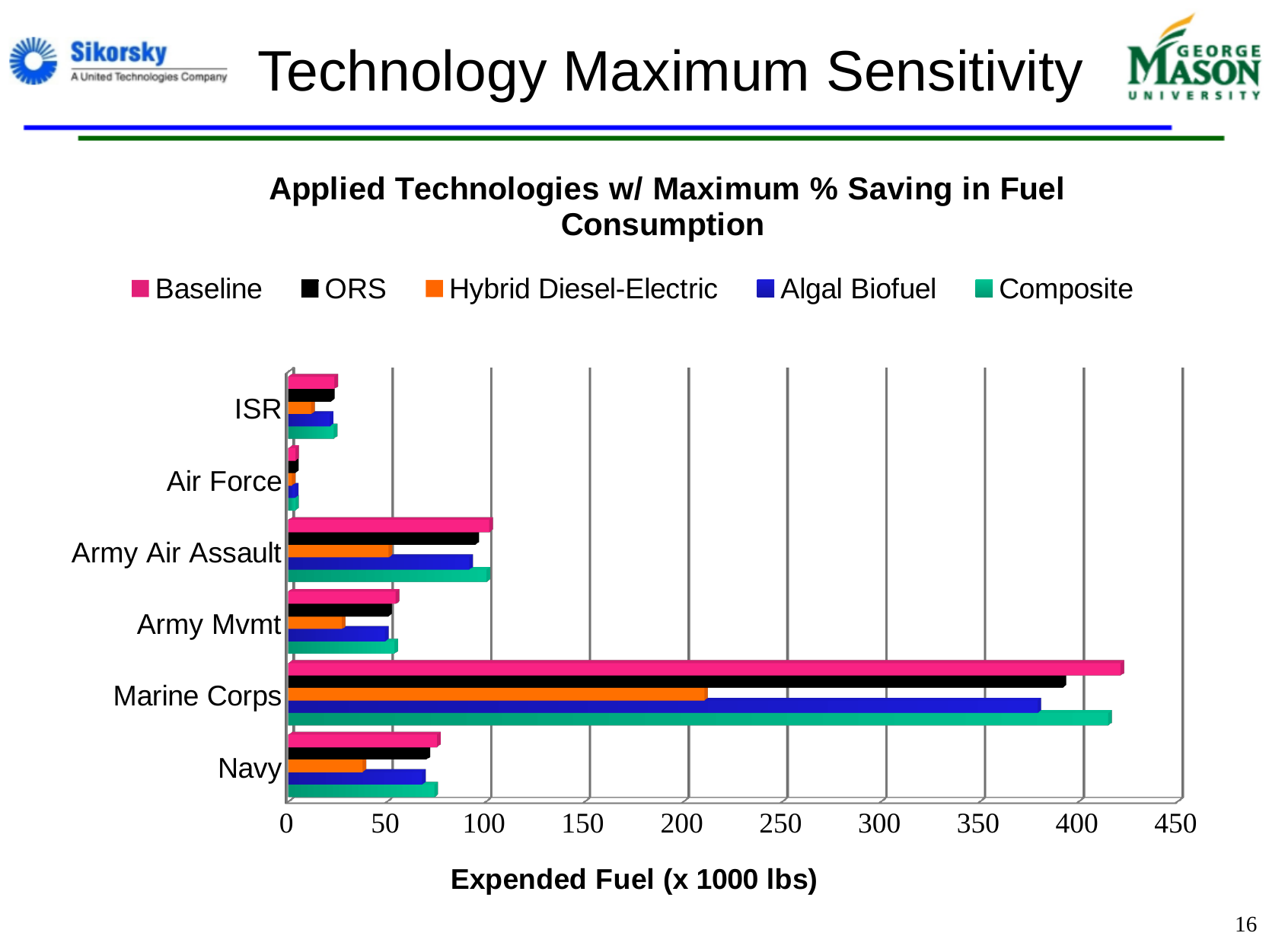
What kind of chart is shown on the slide? bar chart Which category has the highest Baseline value? Marine Corps Which has the larger Baseline value: Army Air Assault or Navy? Army Air Assault Is the Hybrid Diesel-Electric value for Marine Corps greater or less than 250? less How many series does the legend list? 5 Is the Hybrid Diesel-Electric value for Navy greater or less than 50? less Within the Marine Corps category, which series has the lowest value? Hybrid Diesel-Electric What is the title of the x axis? Expended Fuel (x 1000 lbs) Is the Baseline value for Marine Corps greater or less than 400? greater Which category has the lowest Baseline value? Air Force How many categories are plotted on the y axis of the chart? 6 For Marine Corps, which is larger: the Hybrid Diesel-Electric value or the Algal Biofuel value? Algal Biofuel